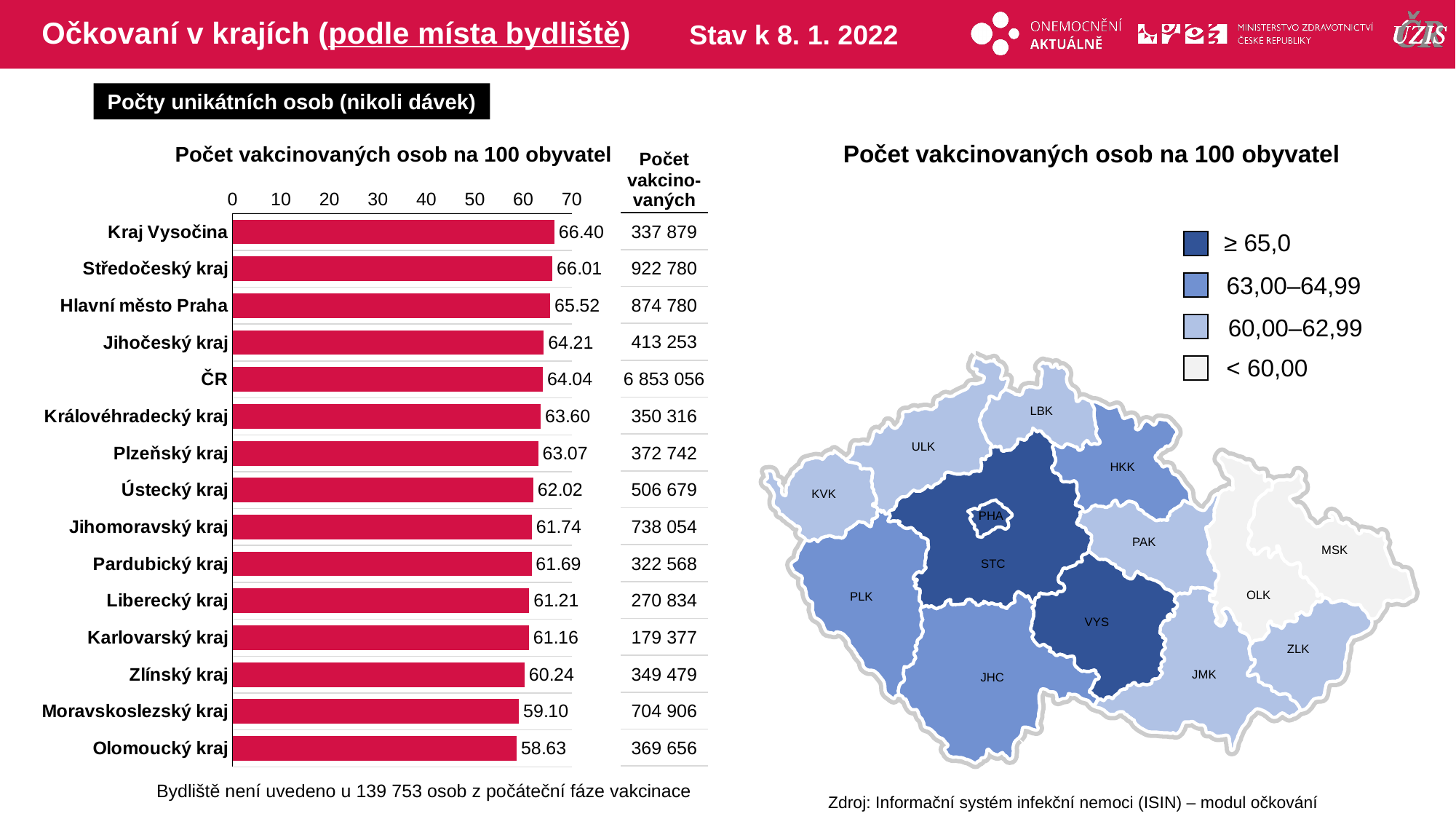
What kind of chart is shown on the left of the slide? bar chart In the bar chart, what is the value for Kraj Vysočina? 66.40 In the bar chart, what is the value for ČR? 64.04 In the bar chart, which category has the lowest value? Olomoucký kraj What is the title of the bar chart? Počet vakcinovaných osob na 100 obyvatel In the bar chart, what is the difference between the values for Středočeský kraj and Hlavní město Praha? 0.49 In the bar chart, what is the value for Plzeňský kraj? 63.07 In the bar chart, which is larger, the value for Jihočeský kraj or the value for Ústecký kraj? Jihočeský kraj How many categories (bars) does the bar chart show? 15 In the bar chart, which category has the highest value? Kraj Vysočina In the bar chart, what is the difference between the values for Kraj Vysočina and Olomoucký kraj? 7.77 In the bar chart, is the value for Moravskoslezský kraj greater or less than 60? less